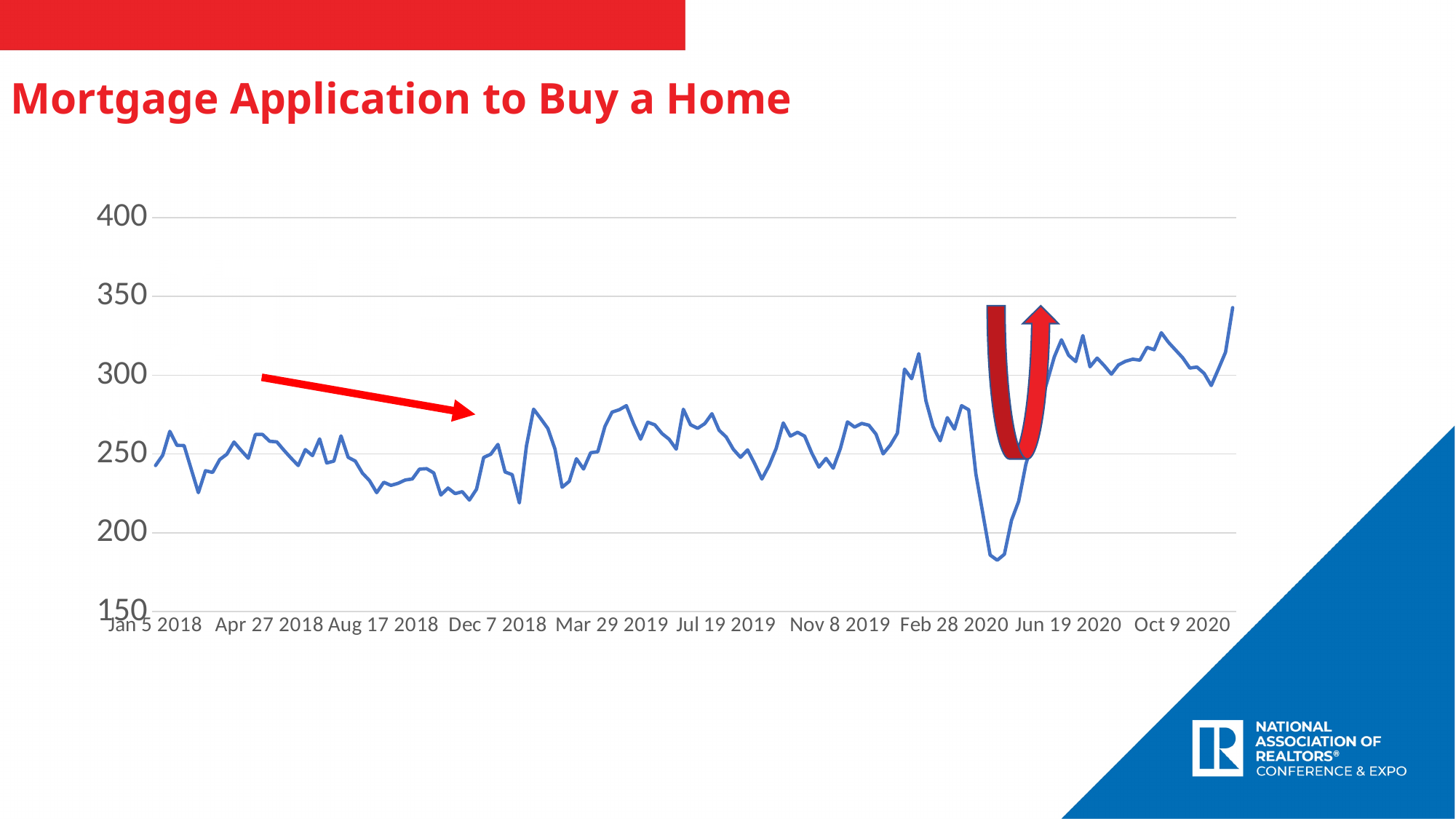
Is the value at Aug 17 2018 greater or less than 300? less Is the highest point of the line greater or less than 350? less Comparing the start of the series (Jan 5 2018) with the end (late 2020), is the value higher or lower at the end? higher Is the value at Jun 19 2020 greater or less than 300? greater What is the highest value shown on the y axis? 400 What is the title of the chart? Mortgage Application to Buy a Home How many date labels are shown on the x axis? 10 What colour is the data line in the chart? blue What kind of chart is shown on the slide? line chart